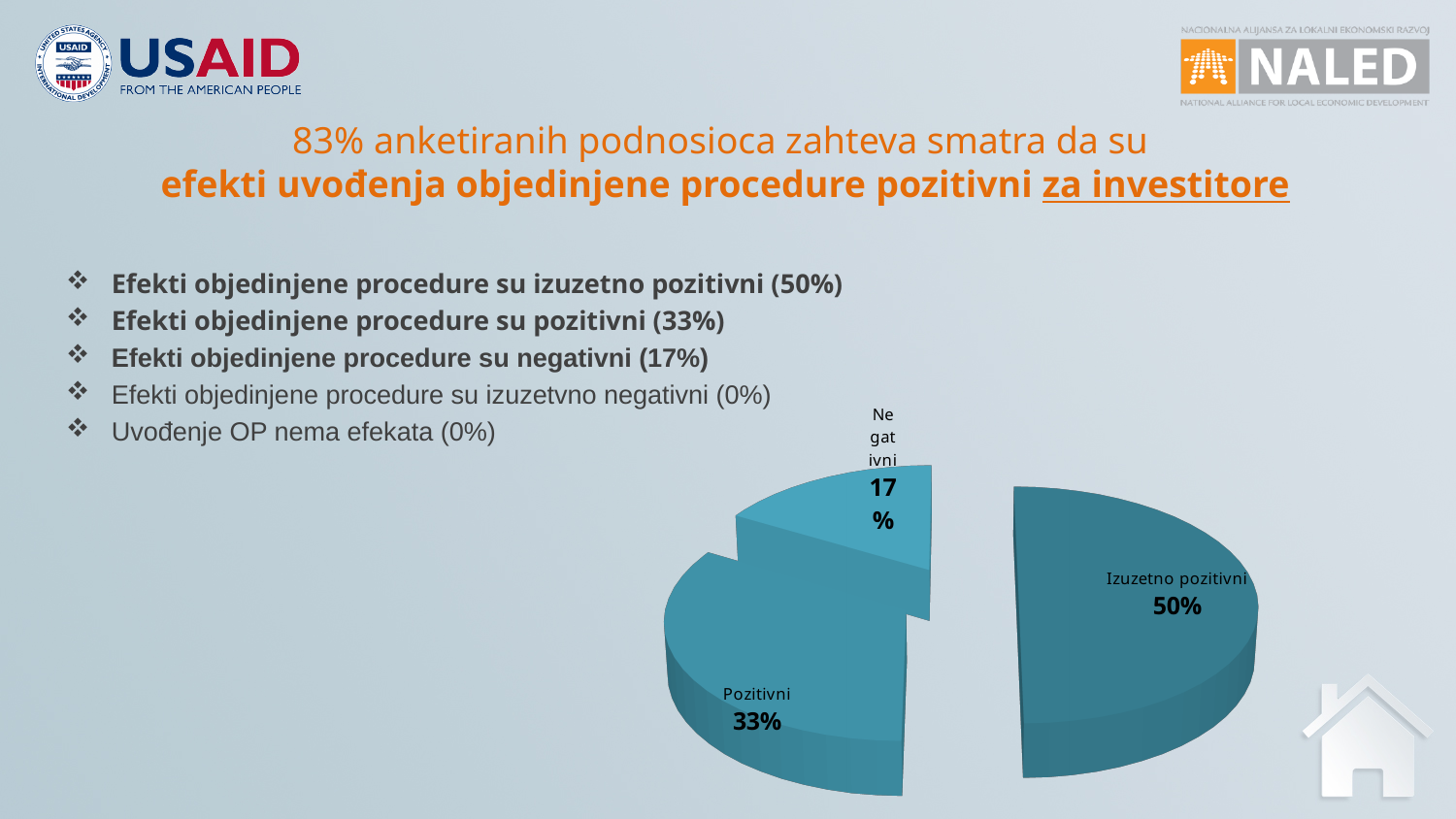
Which slice of the pie chart is the smallest? Negativni What kind of chart is shown on the slide? Pie chart What share of the pie does the "Izuzetno pozitivni" slice represent? 50% What share of the pie does the "Negativni" slice represent? 17% Which slice of the pie chart is the largest? Izuzetno pozitivni What is the combined share of the "Izuzetno pozitivni" and "Pozitivni" slices? 83% Which slice is larger, "Pozitivni" or "Negativni"? Pozitivni How many slices does the pie chart have? 3 What share of the pie does the "Pozitivni" slice represent? 33% What is the difference in percentage points between the "Pozitivni" and "Negativni" slices? 16 What is the difference in percentage points between the "Izuzetno pozitivni" and "Pozitivni" slices? 17 Is the pie chart drawn in 3D or flat 2D? 3D